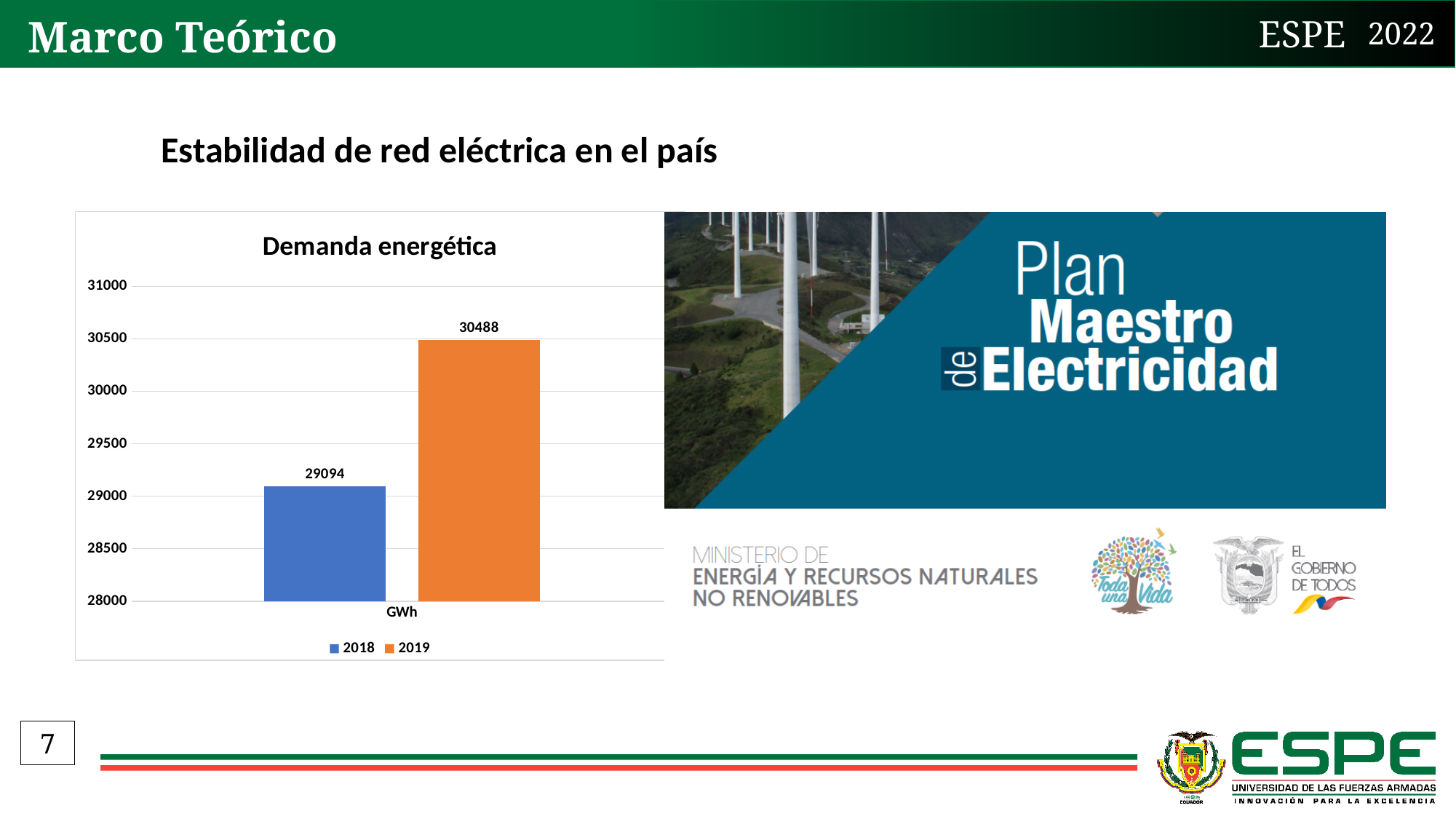
What is the difference between the 2019 and 2018 values in the Demanda energética chart? 1394 What is the value for 2018 in the Demanda energética chart? 29094 Which is larger in the Demanda energética chart, the value for 2018 or the value for 2019? 2019 What is the title of the chart? Demanda energética Which series has the lowest value in the Demanda energética chart? 2018 How many series does the legend of the Demanda energética chart list? 2 Is the value for 2019 greater or less than 30000? greater What is the category label on the x axis of the Demanda energética chart? GWh What is the value for 2019 in the Demanda energética chart? 30488 What type of chart is shown on the slide? bar chart Is the value for 2018 greater or less than 29500? less Which series has the highest value in the Demanda energética chart? 2019